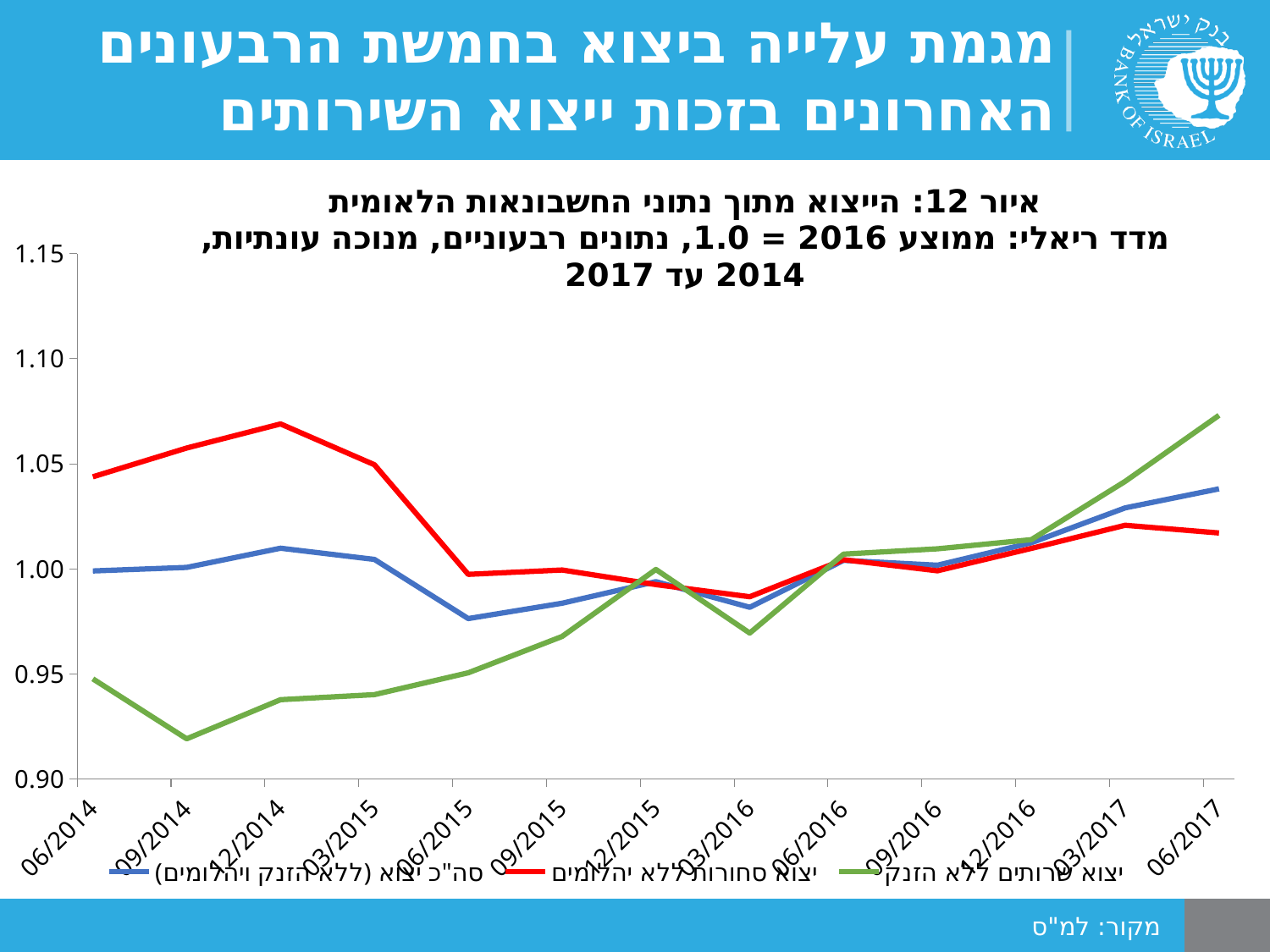
Is the value of יצוא שירותים ללא הזנק (green line) at 09/2014 greater or less than 0.95? less Does the יצוא שירותים ללא הזנק (green) series rise or fall from 03/2016 to 06/2017? rise At 12/2014, which is larger: יצוא סחורות ללא יהלומים (red) or סה"כ יצוא (ללא הזנק ויהלומים) (blue)? יצוא סחורות ללא יהלומים At which date does the יצוא סחורות ללא יהלומים (red) series reach its highest value? 12/2014 How many series does the legend list? 3 Is the value of יצוא סחורות ללא יהלומים (red line) at 12/2014 greater or less than 1.05? greater Is the value of יצוא שירותים ללא הזנק (green line) at 06/2017 greater or less than 1.05? greater What kind of chart is shown on the slide? line chart Which series has the highest value at 06/2017? יצוא שירותים ללא הזנק At which date does the יצוא שירותים ללא הזנק (green) series reach its lowest value? 09/2014 How many quarterly points are shown along the x axis? 13